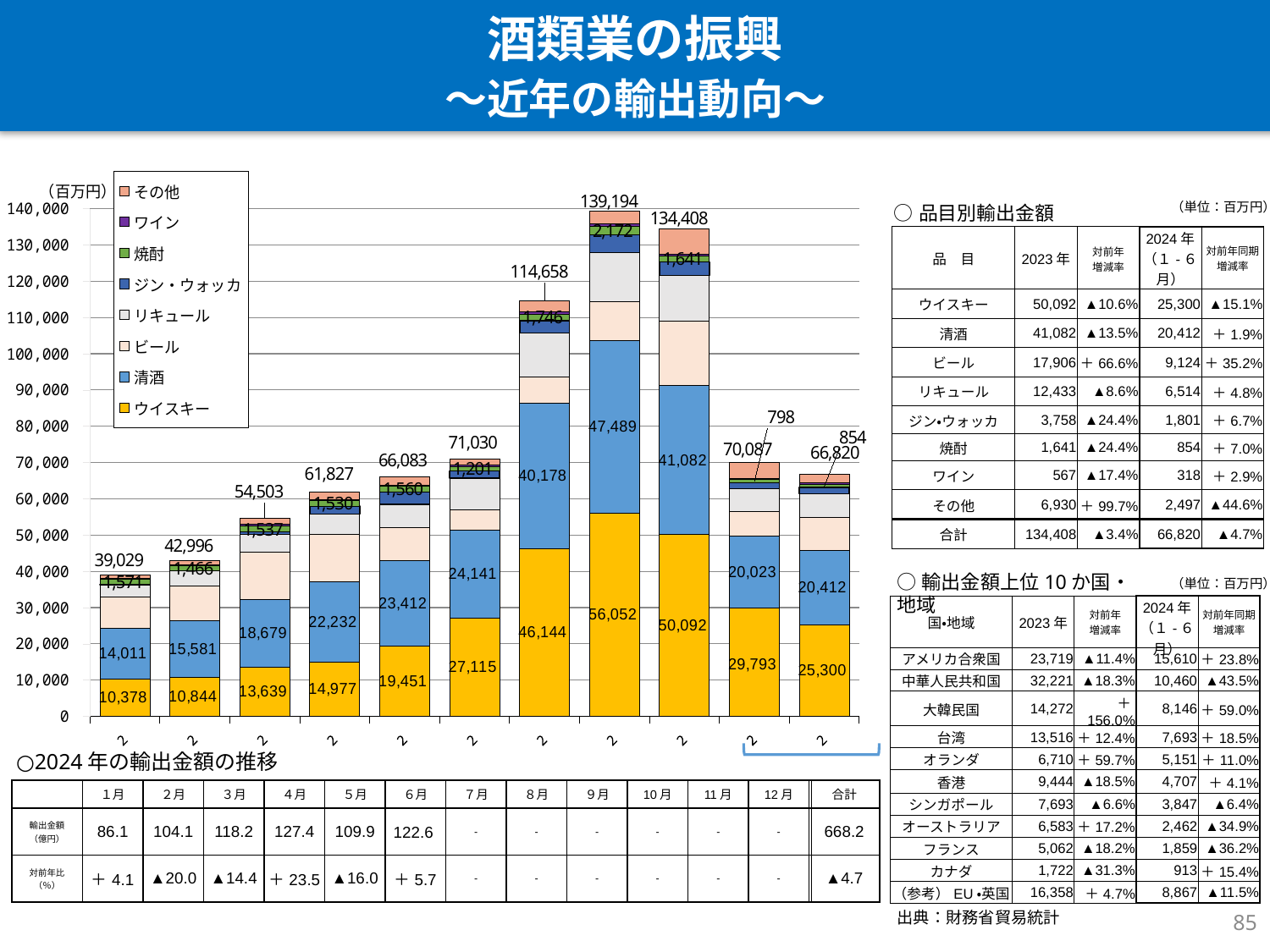
Which bar in the chart has the highest total, and what is that total? The eighth bar from the left, 139,194 In the rightmost bar, which is larger: the ウイスキー value or the 清酒 value? ウイスキー How many bars are plotted in the bar chart? 11 What is the difference between the highest bar total (139,194) and the lowest bar total (39,029)? 100,165 Is the total of the seventh bar from the left greater or less than 100,000? greater What kind of chart is shown on the left of the slide? stacked bar chart What is the total of the ninth bar from the left in the chart? 134,408 What is the ウイスキー value in the rightmost bar of the chart? 25,300 How many series does the legend of the bar chart list? 8 What is the 清酒 value in the leftmost bar of the chart? 14,011 What unit is shown at the top of the y axis of the bar chart? 百万円 What is the total of the lowest bar in the chart? 39,029